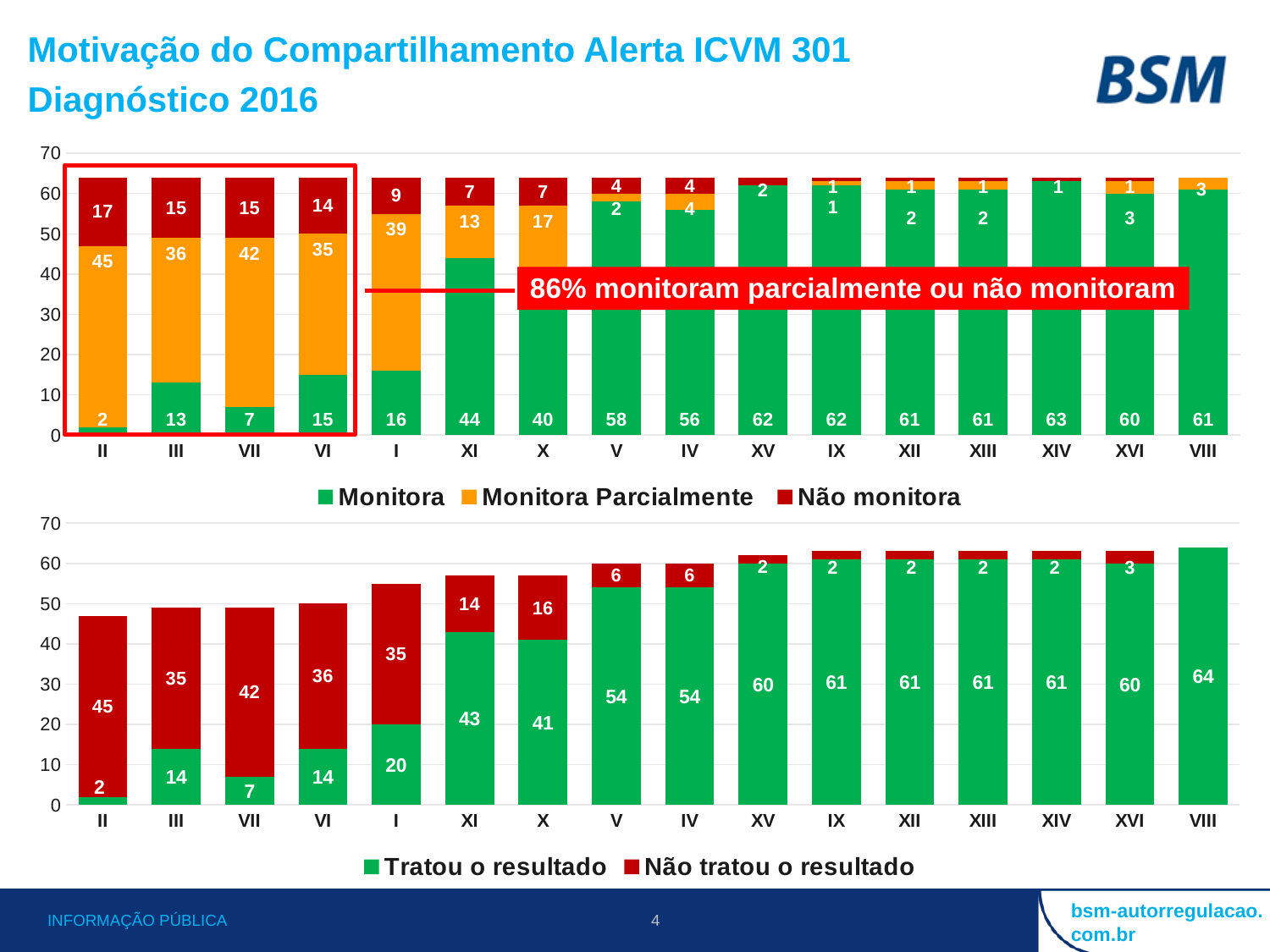
In the top chart, which category has the highest 'Monitora' value? XIV How many categories are shown on the x axis of the bottom chart? 16 In the top chart, what is the 'Monitora Parcialmente' value for category II? 45 What type of chart is the bottom chart? Stacked bar chart In the top chart, what is the 'Não monitora' value for category I? 9 In the top chart, which is larger: the 'Monitora Parcialmente' value for III or for VII? VII How many series does the legend of the top chart list? 3 In the bottom chart, what is the 'Tratou o resultado' value for category XI? 43 In the top chart, what is the difference between the 'Monitora' values for XI and X? 4 In the bottom chart, what is the total of the stacked bar for category I? 55 In the bottom chart, what is the 'Não tratou o resultado' value for category VII? 42 In the bottom chart, which category has the lowest 'Tratou o resultado' value? II